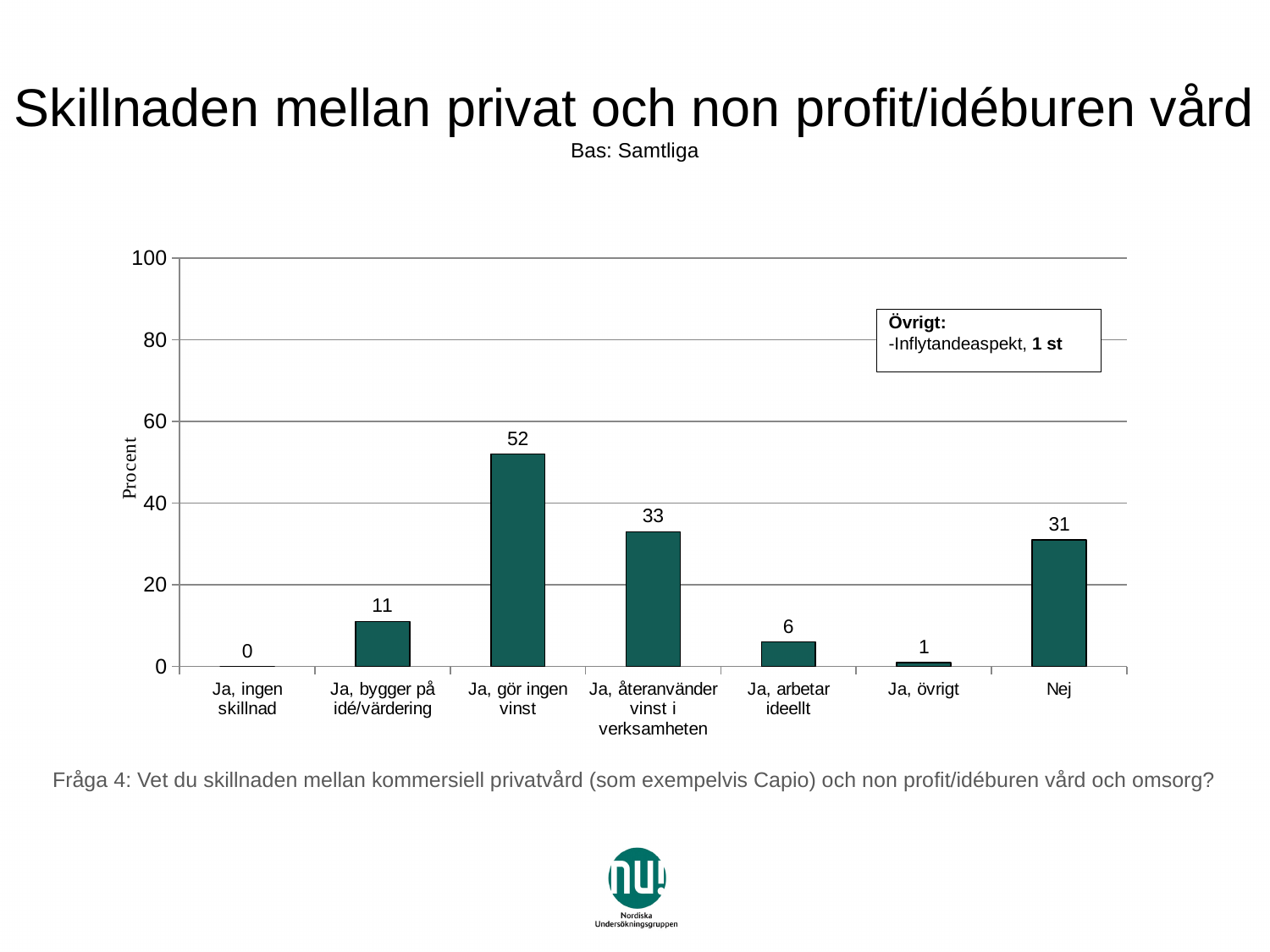
What is the label of the y axis? Procent What is the value for "Ja, gör ingen vinst"? 52 What is the value for "Ja, bygger på idé/värdering"? 11 What is the value for "Nej"? 31 Which category has the lowest value? Ja, ingen skillnad How many categories are shown on the x axis? 7 Which is larger, the value for "Ja, återanvänder vinst i verksamheten" or the value for "Nej"? Ja, återanvänder vinst i verksamheten What is the difference between the values for "Ja, gör ingen vinst" and "Ja, återanvänder vinst i verksamheten"? 19 Is the value for "Ja, gör ingen vinst" greater or less than 40? greater What is the value for "Ja, arbetar ideellt"? 6 What kind of chart is shown on the slide? bar chart Which category has the highest value? Ja, gör ingen vinst